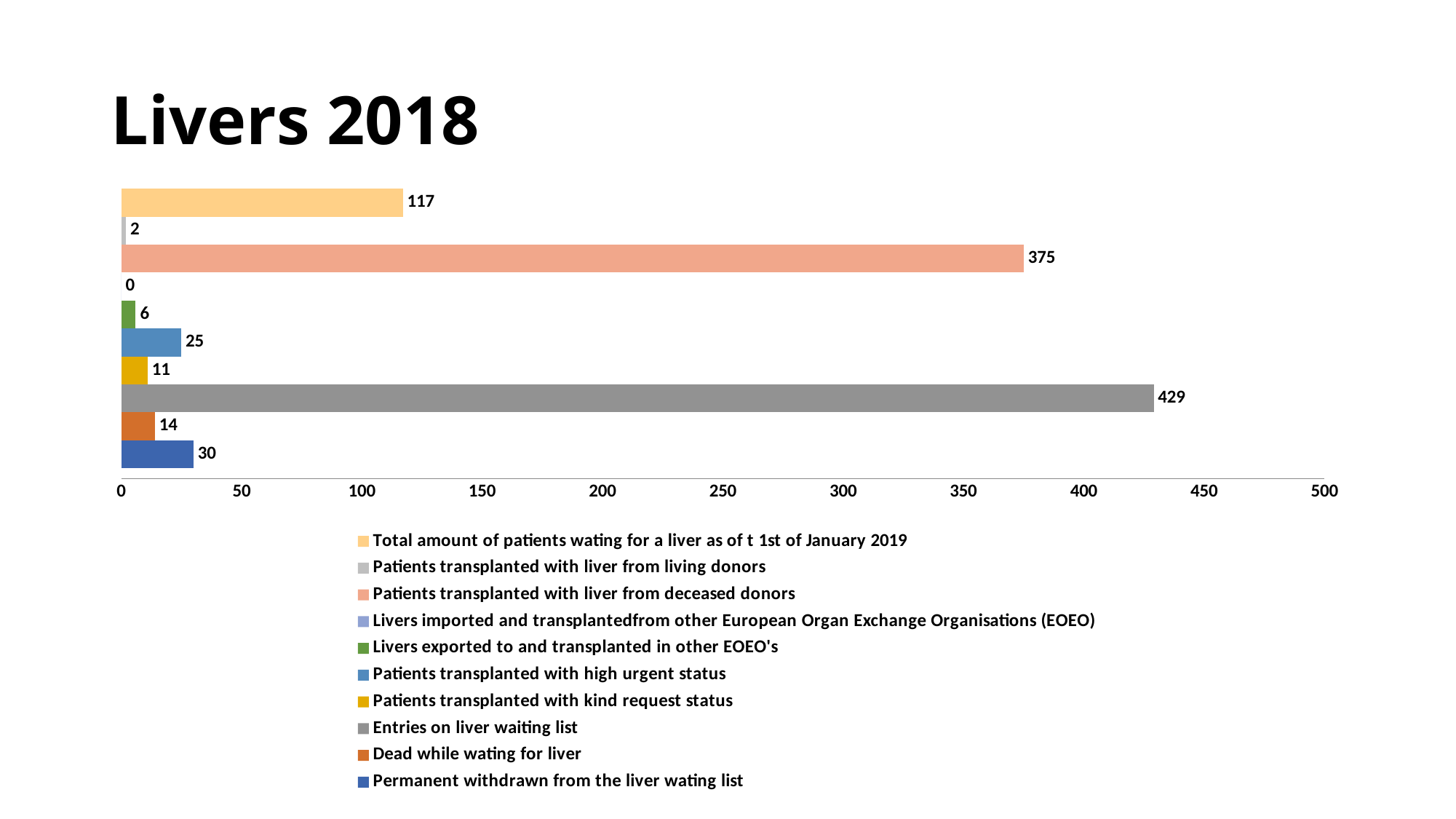
What is the value for Total amount of patients waiting for a liver as of the 1st of January 2019? 117 What is the value for Patients transplanted with liver from deceased donors? 375 Which is larger: Permanent withdrawn from the liver waiting list or Patients transplanted with high urgent status? Permanent withdrawn from the liver waiting list What is the title of the slide? Livers 2018 What is the value for Entries on liver waiting list? 429 Which series has the highest value? Entries on liver waiting list What kind of chart is shown on the slide? Bar chart What is the value for Dead while waiting for liver? 14 What is the difference between Entries on liver waiting list and Patients transplanted with liver from deceased donors? 54 What is the value for Patients transplanted with high urgent status? 25 How many series does the legend list? 10 Which series has the lowest value? Livers imported and transplanted from other European Organ Exchange Organisations (EOEO)